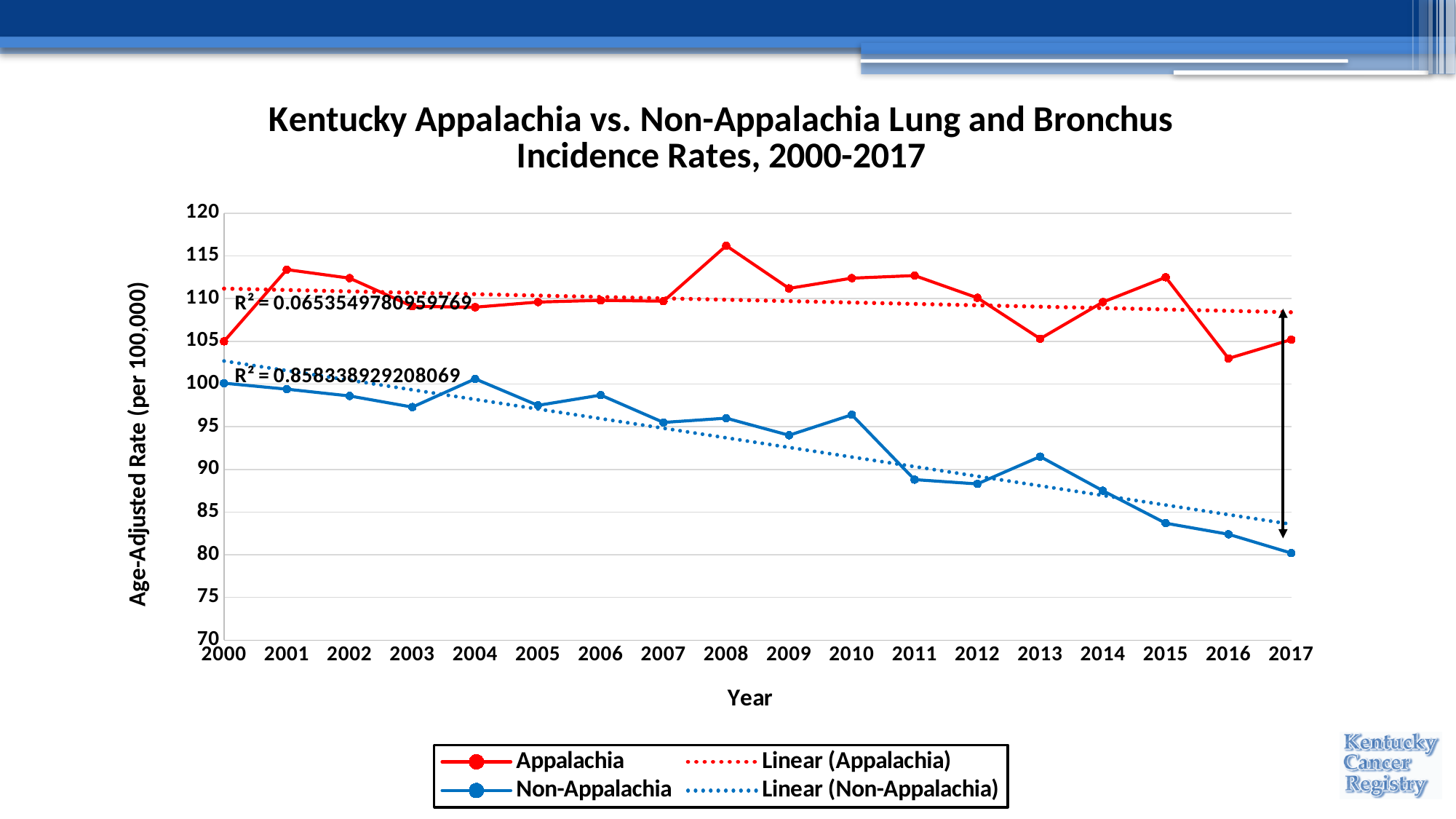
What is the R² value shown for the Non-Appalachia linear trendline? 0.858338929208069 In which year is the Non-Appalachia incidence rate lowest? 2017 What kind of chart is shown on the slide? Line chart Does the Non-Appalachia incidence rate generally rise or fall from 2000 to 2017? Fall How many entries does the legend list? 4 In which year is the Appalachia incidence rate lowest? 2016 In 2017, which series has the higher incidence rate, Appalachia or Non-Appalachia? Appalachia In which year is the Appalachia incidence rate highest? 2008 How many years are plotted along the x axis? 18 Is the Appalachia value for 2013 greater or less than 110? less Is the Appalachia value for 2008 greater or less than 115? greater Is the Non-Appalachia value for 2017 greater or less than 85? less